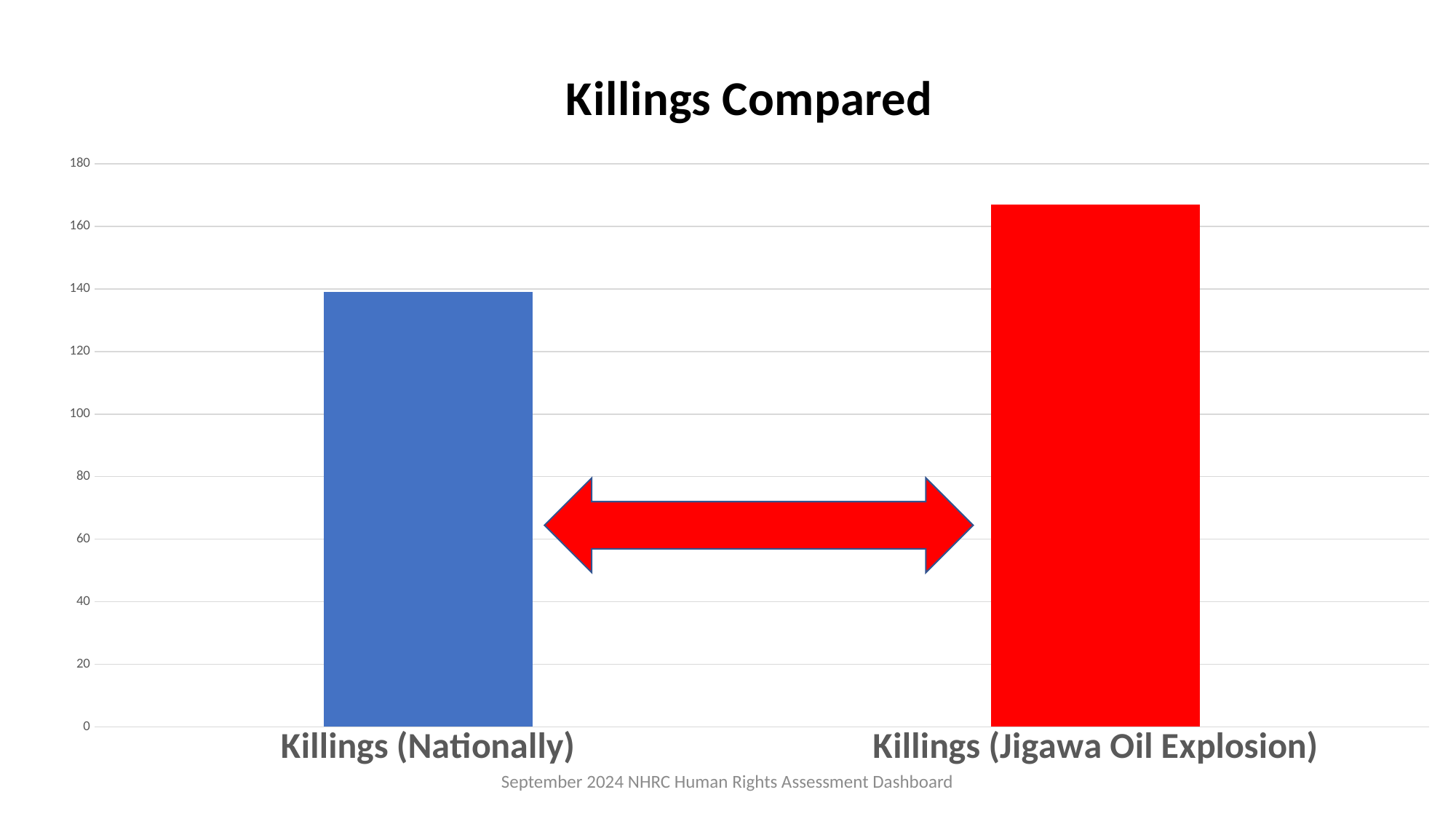
Is the value for Killings (Nationally) greater or less than 160? less How many categories are plotted in the chart? 2 Which category has the lowest value? Killings (Nationally) Is the value for Killings (Jigawa Oil Explosion) greater or less than 160? greater What is the title of the chart? Killings Compared Which category has the highest value? Killings (Jigawa Oil Explosion) Is the value for Killings (Jigawa Oil Explosion) greater or less than 180? less Which is larger, the value for Killings (Nationally) or the value for Killings (Jigawa Oil Explosion)? Killings (Jigawa Oil Explosion) What colour is the bar for Killings (Jigawa Oil Explosion)? red What type of chart is shown on the slide? bar chart